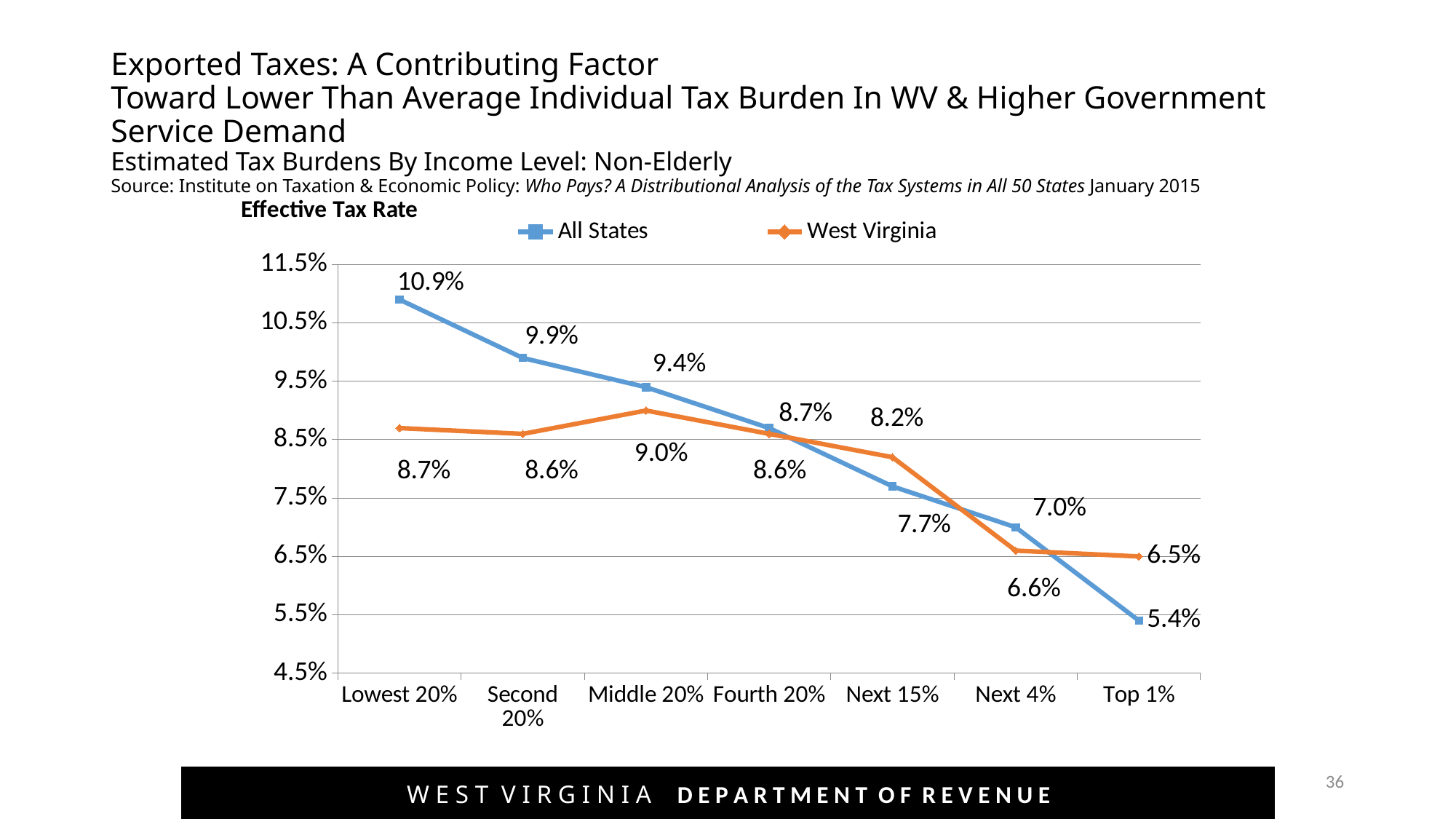
What is the effective tax rate for West Virginia at the Middle 20% income level? 9.0% What is the effective tax rate for All States at the Lowest 20% income level? 10.9% Which income level has the highest effective tax rate for All States? Lowest 20% What is the effective tax rate for West Virginia at the Next 4% income level? 6.6% What is the difference between the All States and West Virginia effective tax rates at the Lowest 20% income level? 2.2% Does the All States effective tax rate rise or fall as income level increases from Lowest 20% to Top 1%? fall At the Top 1% income level, which series has the higher effective tax rate, All States or West Virginia? West Virginia What type of chart is shown on the slide? line chart How many series does the legend list? 2 What is the effective tax rate for All States at the Top 1% income level? 5.4% How many income-level categories are shown on the x axis? 7 Which income level has the lowest effective tax rate for West Virginia? Top 1%